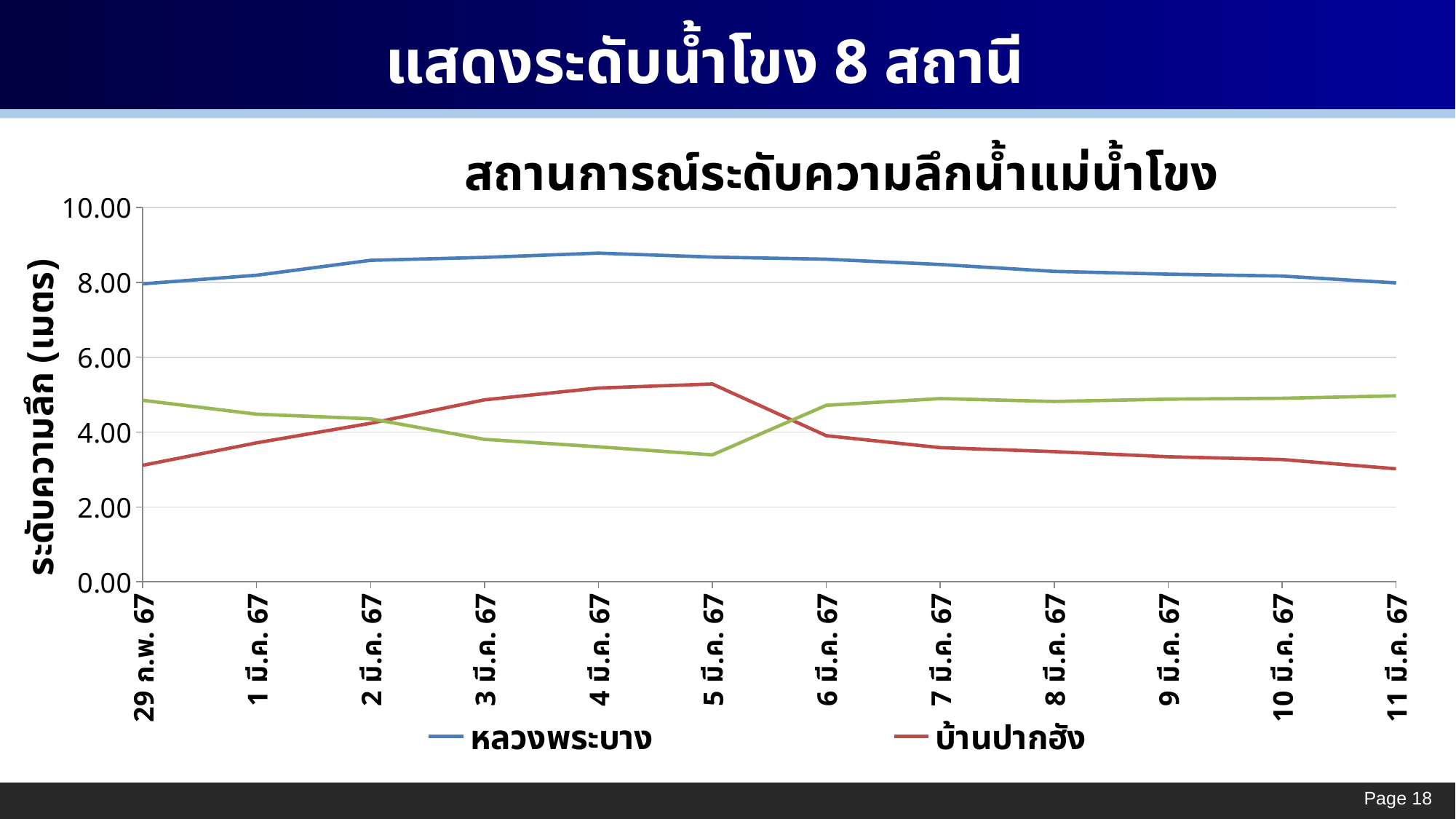
How many series does the chart's legend list? 2 What is the label on the chart's vertical axis? ระดับความลึก (เมตร) Does the บ้านปากฮัง line rise or fall from 5 มี.ค. 67 to 11 มี.ค. 67? fall Is the value for หลวงพระบาง on 4 มี.ค. 67 greater or less than 8.00? greater Is the value for บ้านปากฮัง on 29 ก.พ. 67 greater or less than 4.00? less On 29 ก.พ. 67, which line is higher, the red บ้านปากฮัง line or the green line? the green line Is the value for บ้านปากฮัง on 5 มี.ค. 67 greater or less than 4.00? greater What kind of chart is shown on the slide? line chart How many dates are shown along the x axis of the chart? 12 Does the บ้านปากฮัง line rise or fall from 29 ก.พ. 67 to 5 มี.ค. 67? rise On 11 มี.ค. 67, which line is higher, the red บ้านปากฮัง line or the green line? the green line Which series has the higher value on 5 มี.ค. 67, หลวงพระบาง or บ้านปากฮัง? หลวงพระบาง